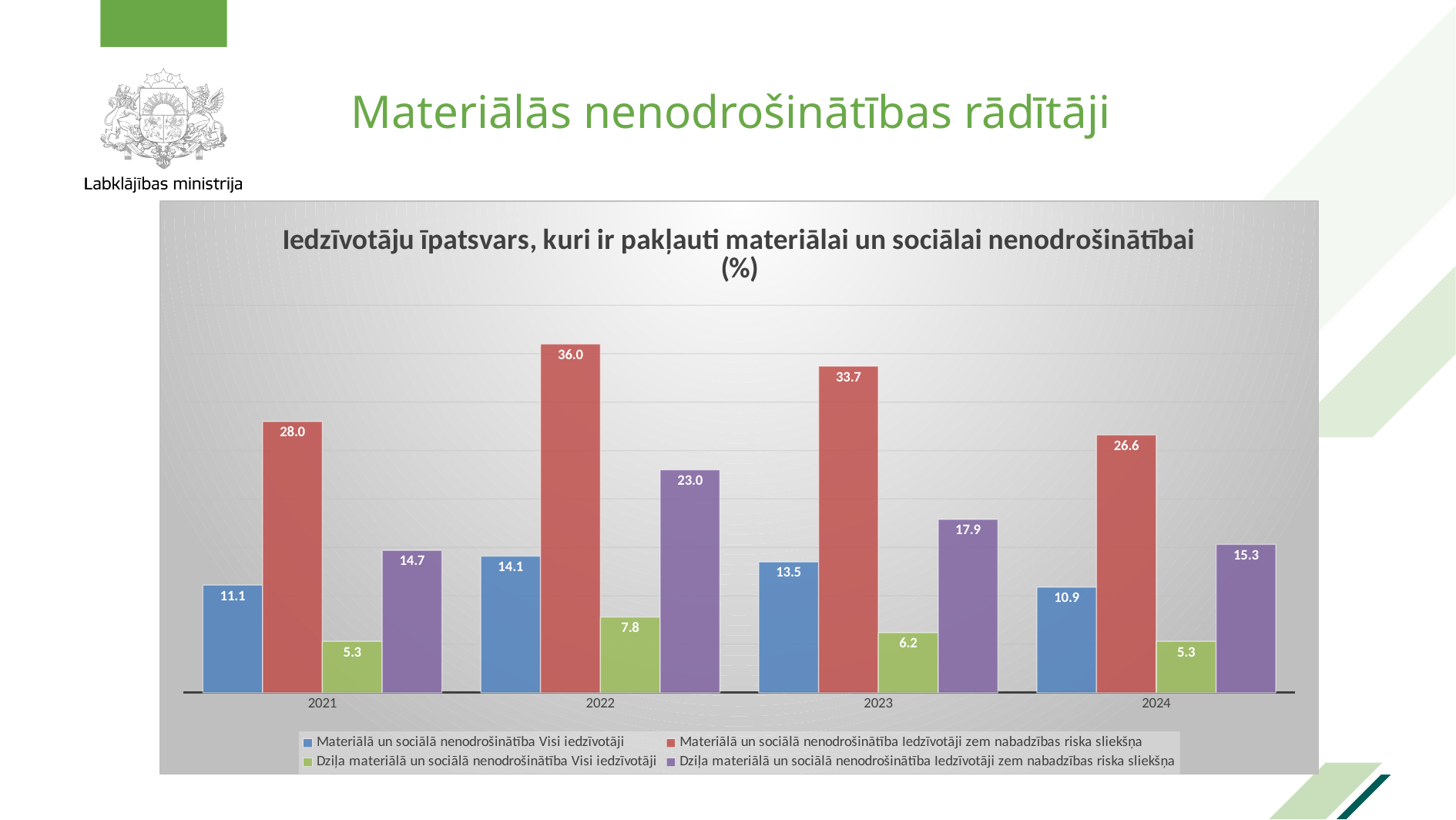
What is the difference between the 'Materiālā un sociālā nenodrošinātība Iedzīvotāji zem nabadzības riska sliekšņa' values for 2022 and 2024? 9.4 How many years are shown on the x axis? 4 In which year is the value for 'Materiālā un sociālā nenodrošinātība Visi iedzīvotāji' lowest? 2024 In which year is the value for 'Materiālā un sociālā nenodrošinātība Iedzīvotāji zem nabadzības riska sliekšņa' highest? 2022 What is the value for 'Dziļa materiālā un sociālā nenodrošinātība Visi iedzīvotāji' in 2023? 6.2 What is the value for 'Dziļa materiālā un sociālā nenodrošinātība Iedzīvotāji zem nabadzības riska sliekšņa' in 2021? 14.7 What kind of chart is shown on the slide? Bar chart How many series does the legend list? 4 Does the value for 'Dziļa materiālā un sociālā nenodrošinātība Iedzīvotāji zem nabadzības riska sliekšņa' rise or fall from 2022 to 2023? Fall What is the value for 'Materiālā un sociālā nenodrošinātība Visi iedzīvotāji' in 2024? 10.9 What is the value for 'Materiālā un sociālā nenodrošinātība Iedzīvotāji zem nabadzības riska sliekšņa' in 2022? 36.0 Which is larger: the 'Dziļa materiālā un sociālā nenodrošinātība Iedzīvotāji zem nabadzības riska sliekšņa' value in 2023 or in 2024? 2023